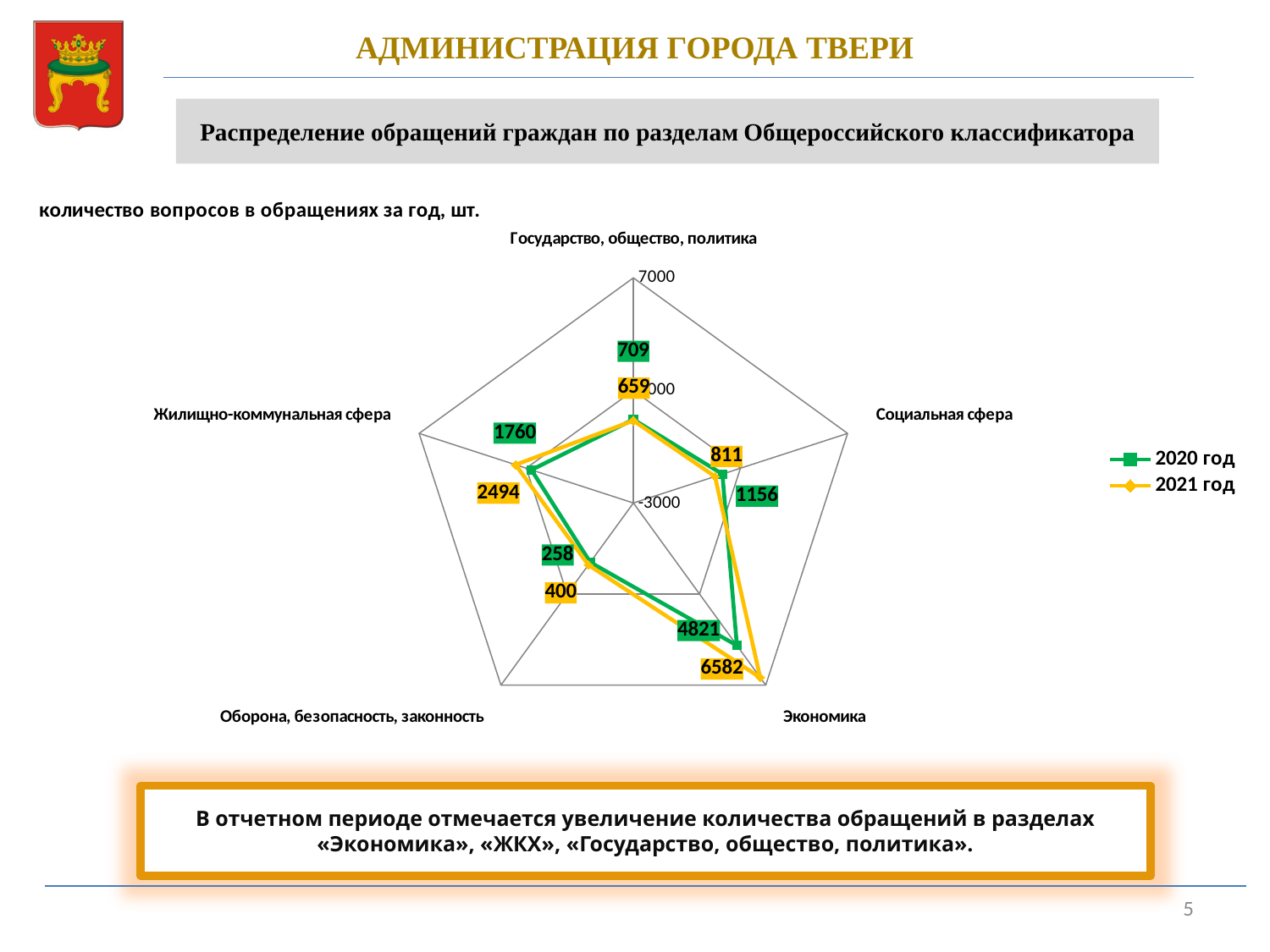
Which category has the lowest value in the 2020 год series? Оборона, безопасность, законность What is the value for Жилищно-коммунальная сфера in the 2021 год series? 2494 What kind of chart is shown on the slide? Radar chart How many categories (axes) does the radar chart have? 5 What is the difference between the 2021 год and 2020 год values for Экономика? 1761 How many series does the legend list? 2 What is the value for Социальная сфера in the 2020 год series? 1156 What are the two entries in the chart legend? 2020 год and 2021 год What is the value for Экономика in the 2020 год series? 4821 What is the value for Экономика in the 2021 год series? 6582 For Социальная сфера, which series has the larger value, 2020 год or 2021 год? 2020 год Which category has the highest value in the 2021 год series? Экономика